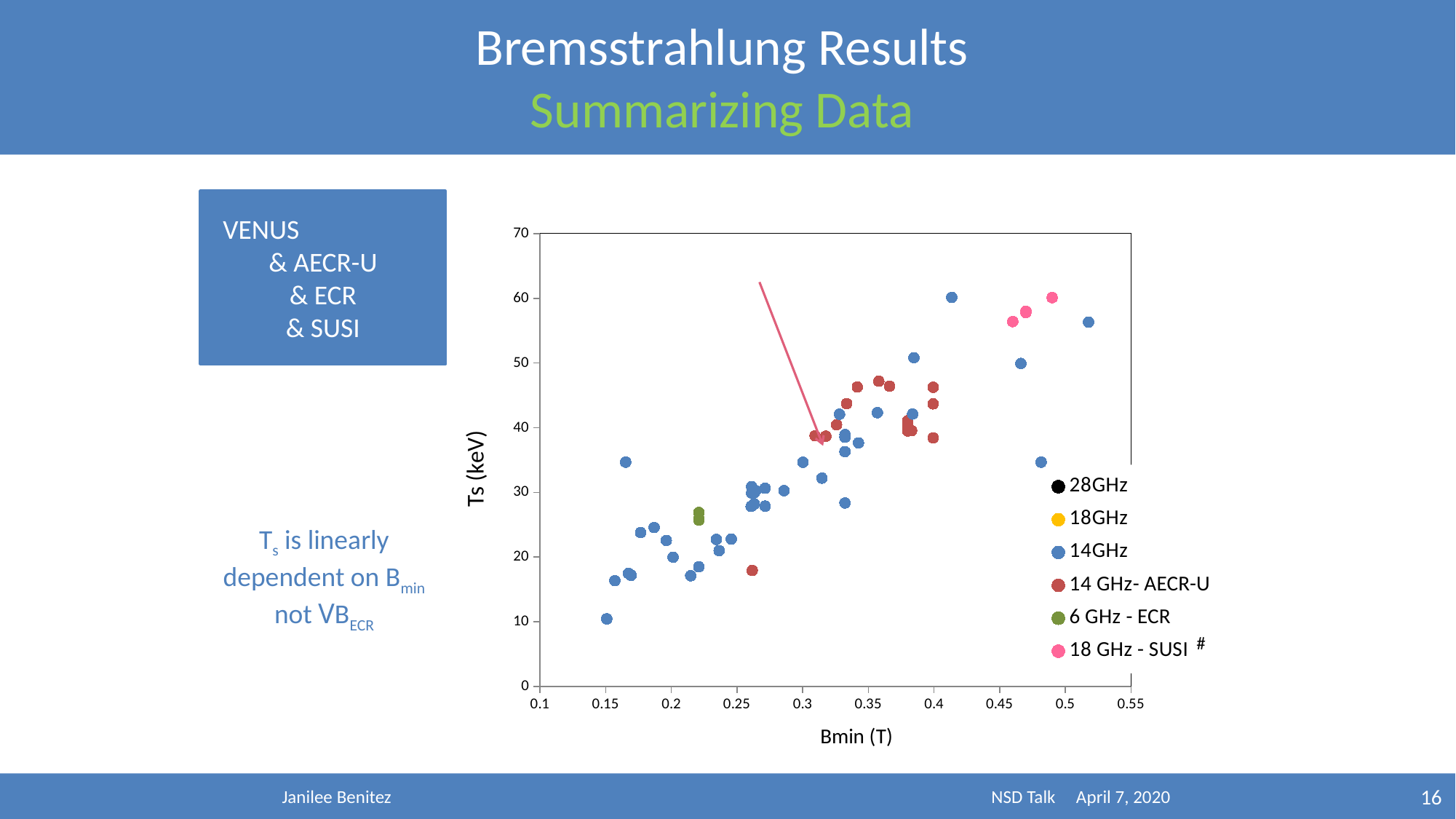
Are the 18 GHz - SUSI points greater or less than 50 keV? greater What is the label of the x axis of the chart? Bmin (T) What kind of chart is shown on the slide? scatter chart Is the lowest 14GHz point greater or less than 20 keV? less Which series contains the lowest plotted point on the chart? 14GHz Is the highest 14 GHz- AECR-U point greater or less than 40 keV? greater Do the Ts values generally rise or fall as Bmin increases along the x axis? rise How many series does the chart legend list? 6 What is the label of the y axis of the chart? Ts (keV) Which series has higher Ts values, 6 GHz - ECR or 18 GHz - SUSI? 18 GHz - SUSI